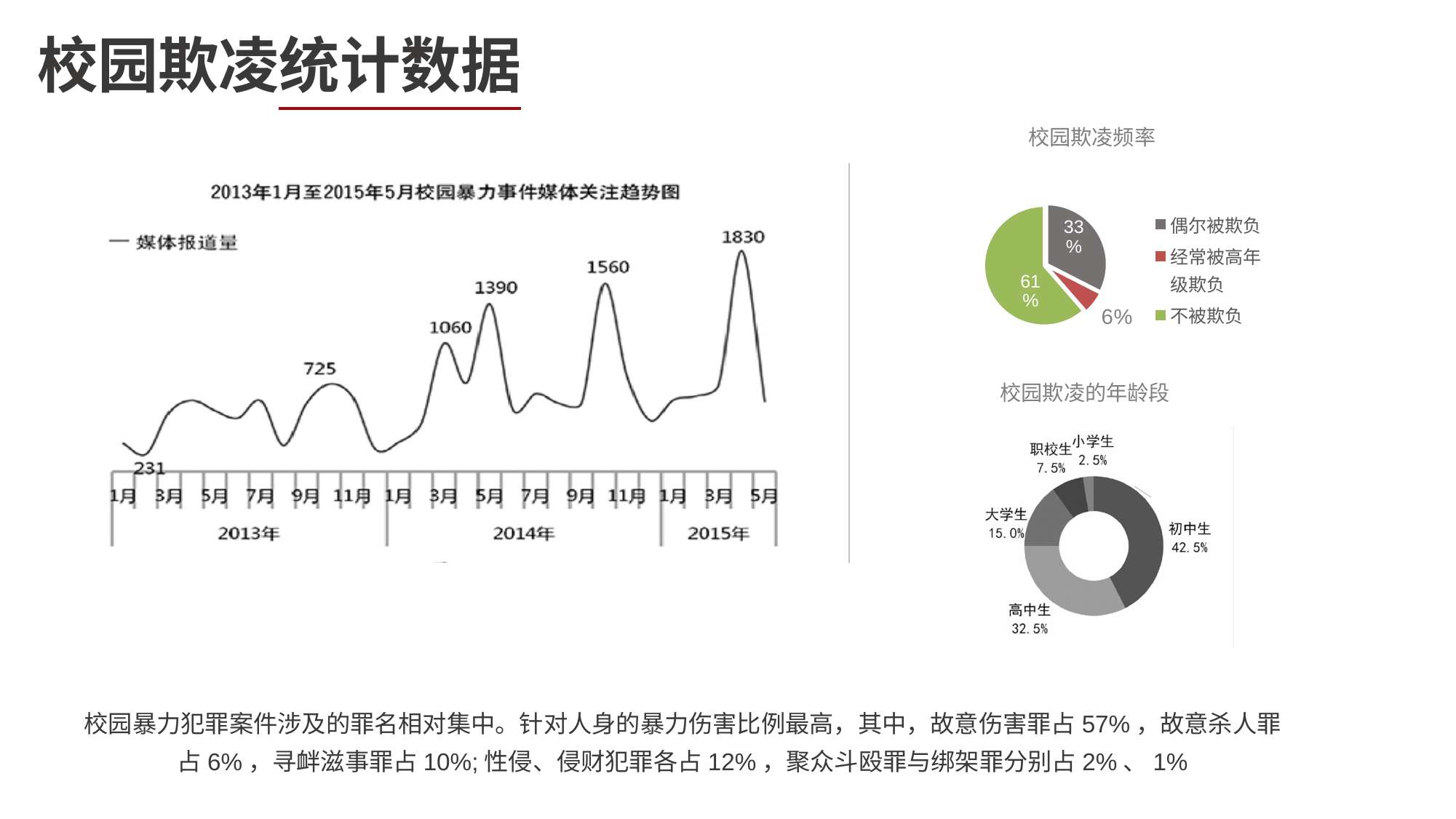
In the donut chart titled 校园欺凌的年龄段, what percentage is shown for 初中生? 42.5% In the donut chart titled 校园欺凌的年龄段, what is the difference between the percentages for 初中生 and 高中生? 10.0% In the pie chart titled 校园欺凌频率, what share is labelled for 不被欺负? 61% In the line chart on the left, what is the lowest labelled value of 媒体报道量? 231 In the donut chart titled 校园欺凌的年龄段, which age group has the lowest percentage? 小学生 In the donut chart titled 校园欺凌的年龄段, how many age groups are shown? 5 In the pie chart titled 校园欺凌频率, what share is labelled for 偶尔被欺负? 33% In the pie chart titled 校园欺凌频率, how many categories does the legend list? 3 In the donut chart titled 校园欺凌的年龄段, what percentage is shown for 高中生? 32.5% In the line chart on the left, what is the highest labelled value of 媒体报道量? 1830 In the pie chart titled 校园欺凌频率, which category has the smallest slice? 经常被高年级欺负 What kind of chart is the chart on the left titled 2013年1月至2015年5月校园暴力事件媒体关注趋势图? line chart